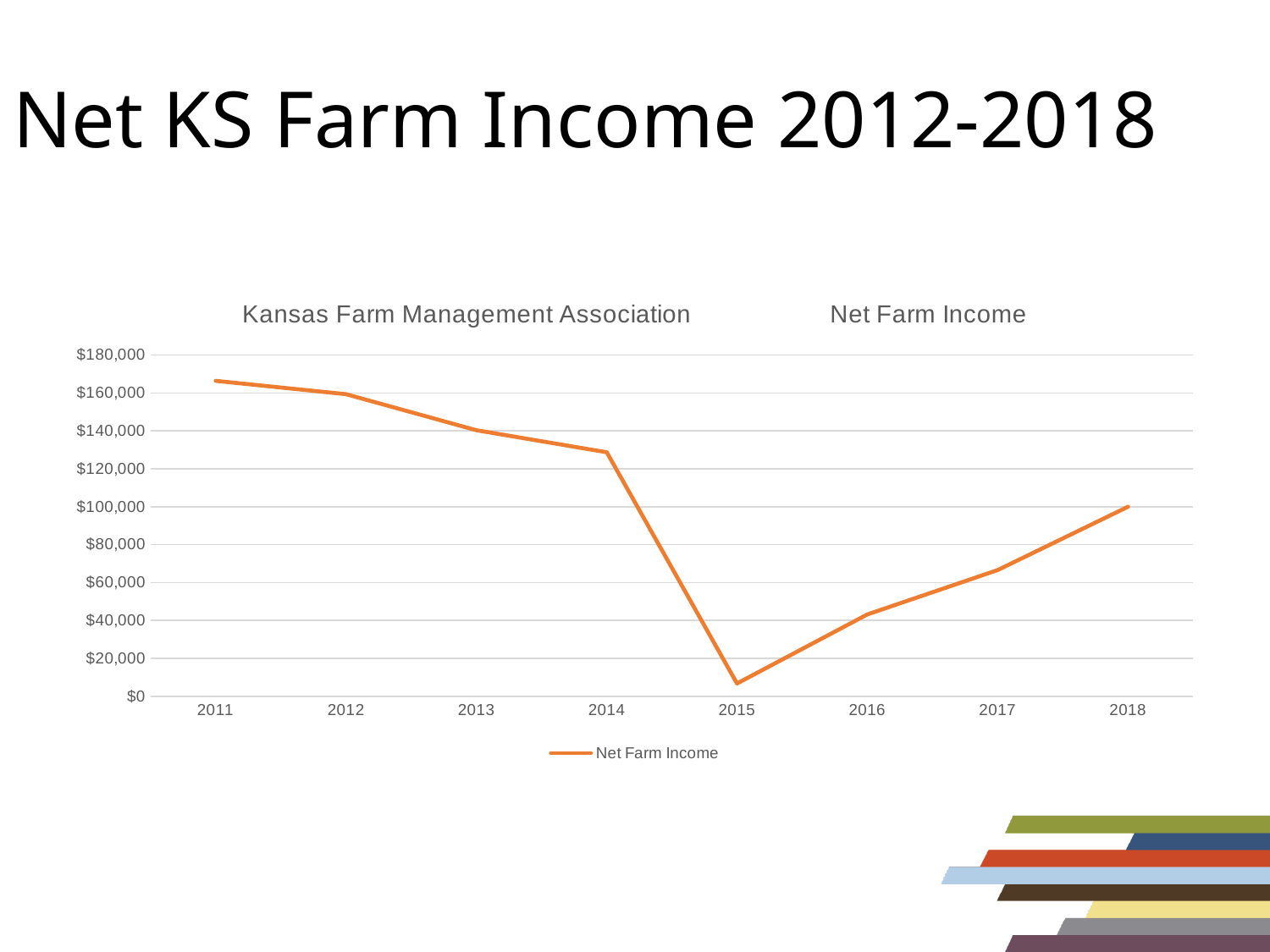
Which year has the larger Net Farm Income, 2012 or 2016? 2012 Does Net Farm Income rise or fall from 2011 to 2014? fall What kind of chart is shown on the slide? line chart How many series does the chart's legend list? 1 Does Net Farm Income rise or fall from 2015 to 2018? rise Is the Net Farm Income for 2017 greater or less than $60,000? greater Which year has the lowest Net Farm Income? 2015 Is the Net Farm Income for 2015 greater or less than $20,000? less Is the Net Farm Income for 2014 greater or less than $120,000? greater Which year has the highest Net Farm Income? 2011 How many years are plotted on the x axis of the chart? 8 What series name is shown in the chart's legend? Net Farm Income